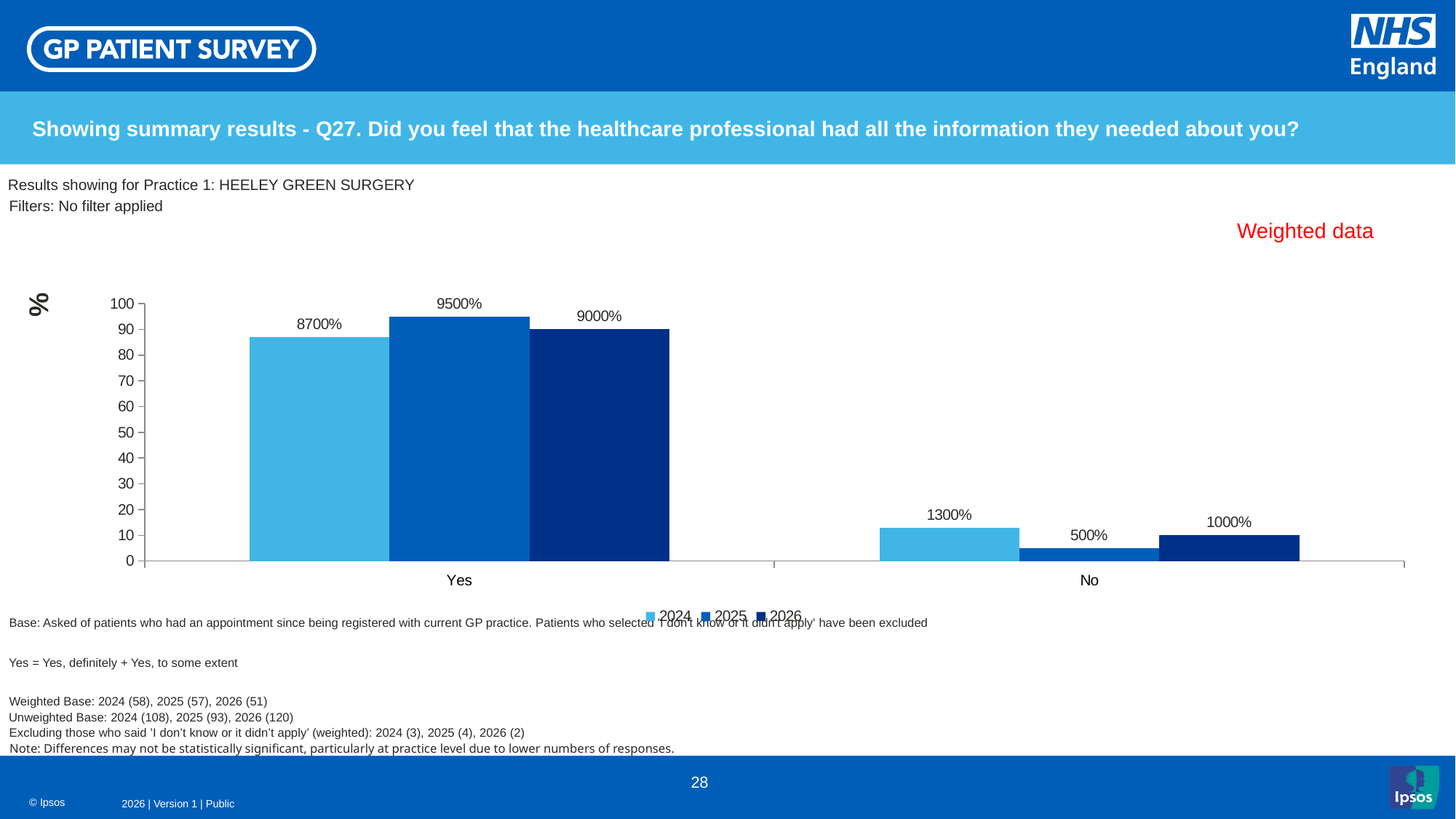
What is the difference between the 2025 and 2024 data labels for Yes? 800% How many series does the legend list? 3 What is the data label on the 2025 bar for No? 500% How many categories are shown on the x axis? 2 Is the 2024 bar for No greater or less than 20 on the axis? less What kind of chart is shown on the slide? bar chart What is the data label on the 2025 bar for Yes? 9500% Which is larger for Yes: the 2026 bar or the 2024 bar? 2026 Which year has the lowest bar for No? 2025 What is the data label on the 2026 bar for No? 1000% Which year has the highest bar for Yes? 2025 What is the data label on the 2024 bar for Yes? 8700%